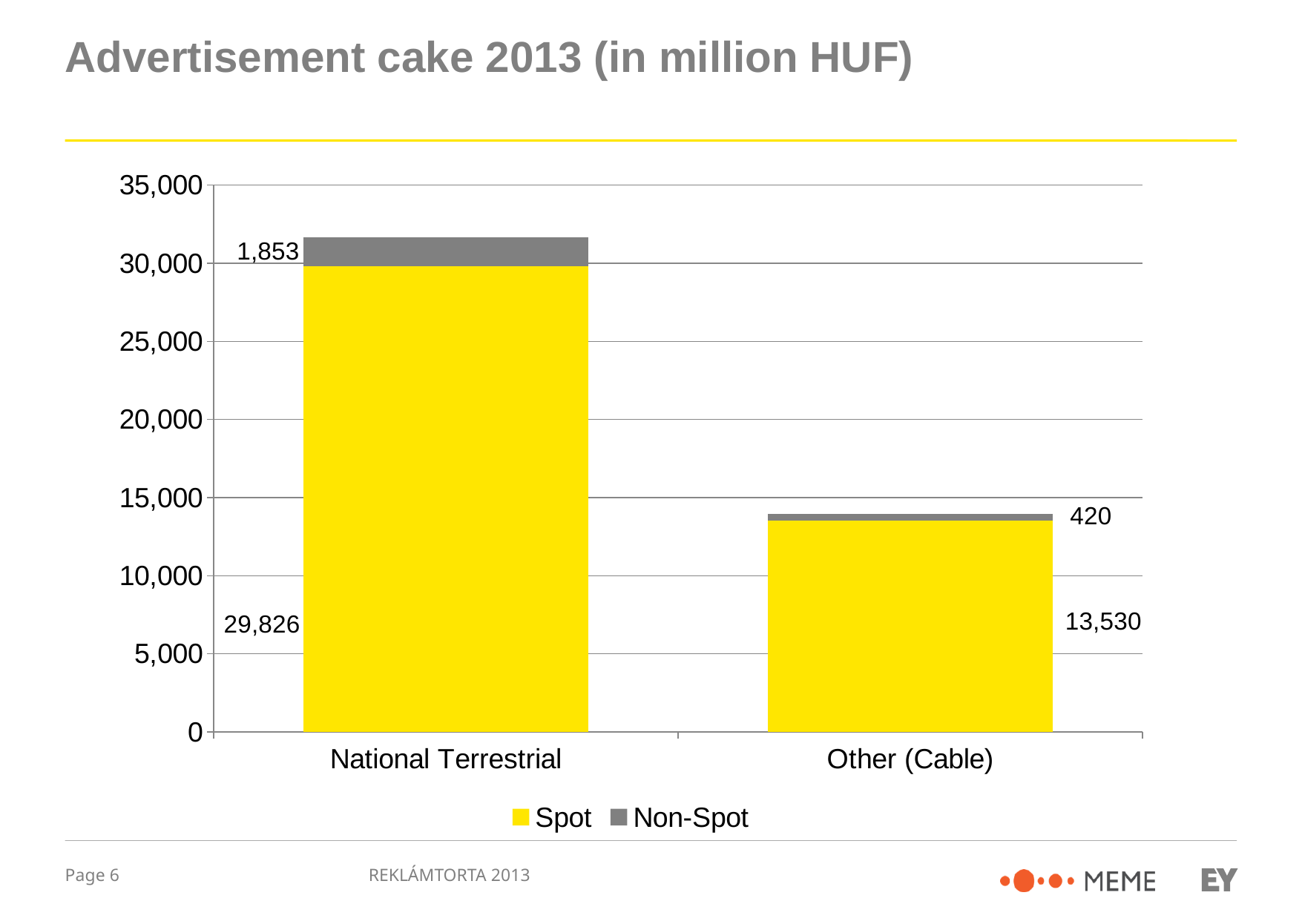
What is the difference between the Spot values for National Terrestrial and Other (Cable)? 16,296 What is the Non-Spot value for Other (Cable)? 420 Is the Non-Spot value for National Terrestrial larger or smaller than the Non-Spot value for Other (Cable)? larger What is the total of the stacked bar for National Terrestrial? 31,679 What is the total of the stacked bar for Other (Cable)? 13,950 How many series does the legend list? 2 What is the Spot value for National Terrestrial? 29,826 What kind of chart is shown on the slide? stacked bar chart What is the Spot value for Other (Cable)? 13,530 Which category has the lowest Non-Spot value? Other (Cable) Which category has the highest Spot value? National Terrestrial What is the Non-Spot value for National Terrestrial? 1,853